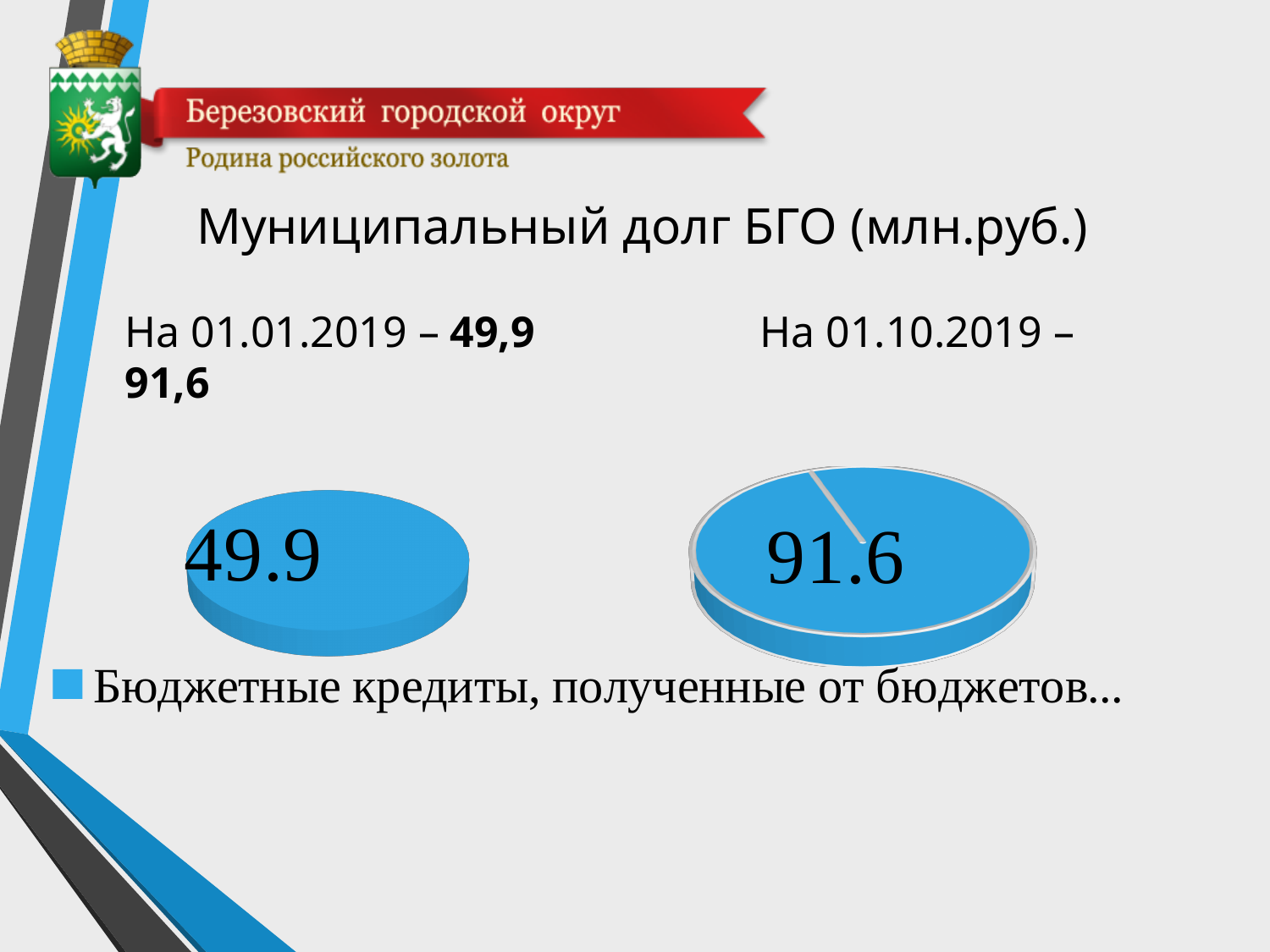
What is the difference between the value on the right pie chart and the value on the left pie chart? 41.7 Is the value on the left pie chart greater or less than 50? less Is the value on the right pie chart greater or less than 90? greater Which pie chart shows the larger value, the left one or the right one? The right one What kind of charts are shown on the slide? Pie charts What value is shown on the right pie chart? 91.6 What is the title above the charts? Муниципальный долг БГО (млн.руб.) What value is shown on the left pie chart? 49.9 How many slices does the left pie chart have? 1 How many pie charts are on the slide? 2 What colour are the pie charts? Blue How many entries does the legend below the charts list? 1